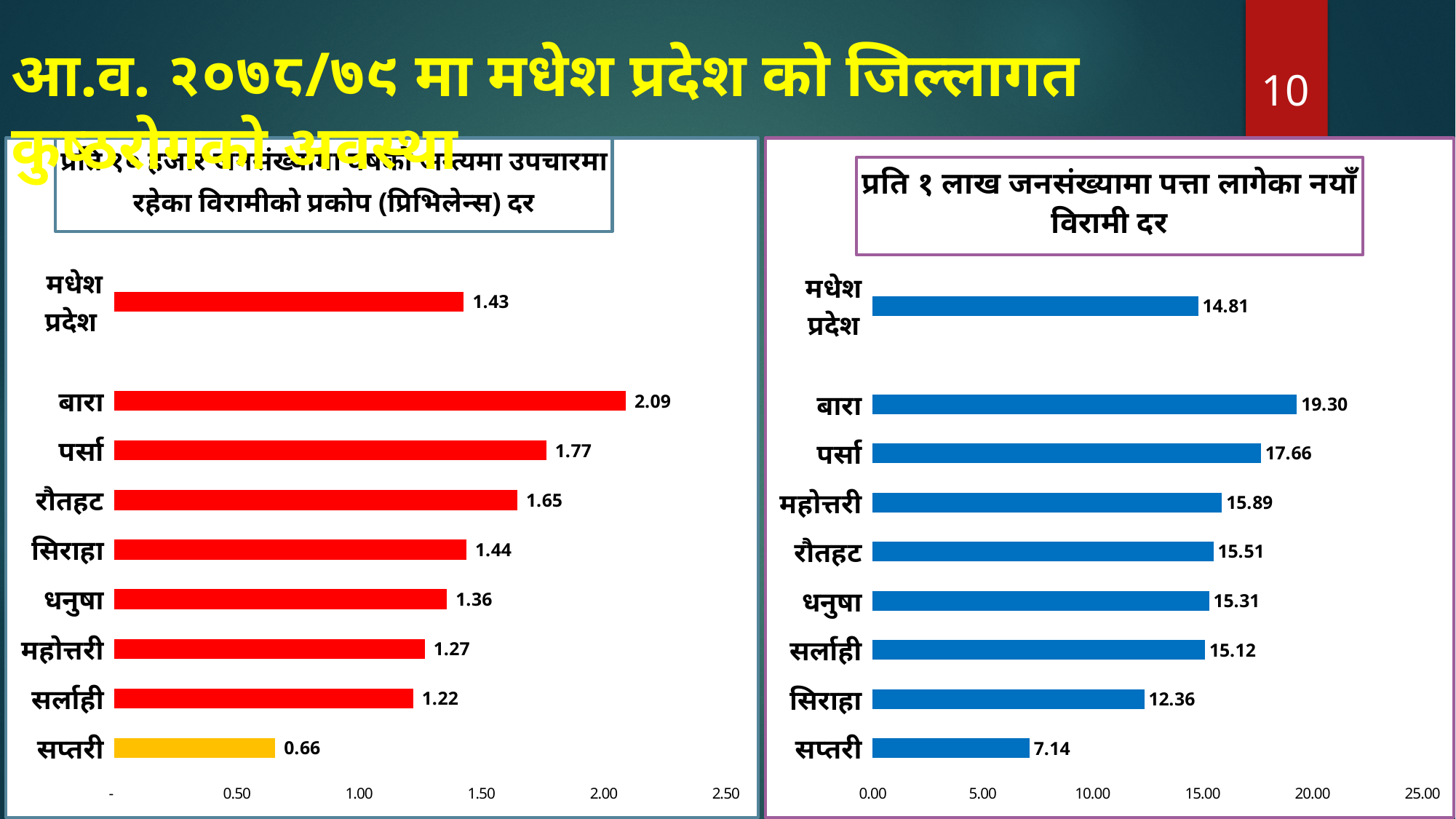
In the left chart, which is larger, the value for पर्सा or the value for धनुषा? पर्सा In the right chart, what is the difference between the values for पर्सा and सप्तरी? 10.52 In the right chart, what is the value for मधेश प्रदेश? 14.81 How many bars are plotted in the right chart? 9 In the right chart, what is the value for सिराहा? 12.36 In the left chart, what is the value for बारा? 2.09 What kind of chart is the left chart? bar chart In the right chart, which category has the highest value? बारा In the left chart, which category has the lowest value? सप्तरी In the left chart, what is the difference between the values for बारा and सप्तरी? 1.43 In the left chart, which bar is coloured differently from the others? सप्तरी In the right chart, is the value for सप्तरी greater or less than 10.00? less